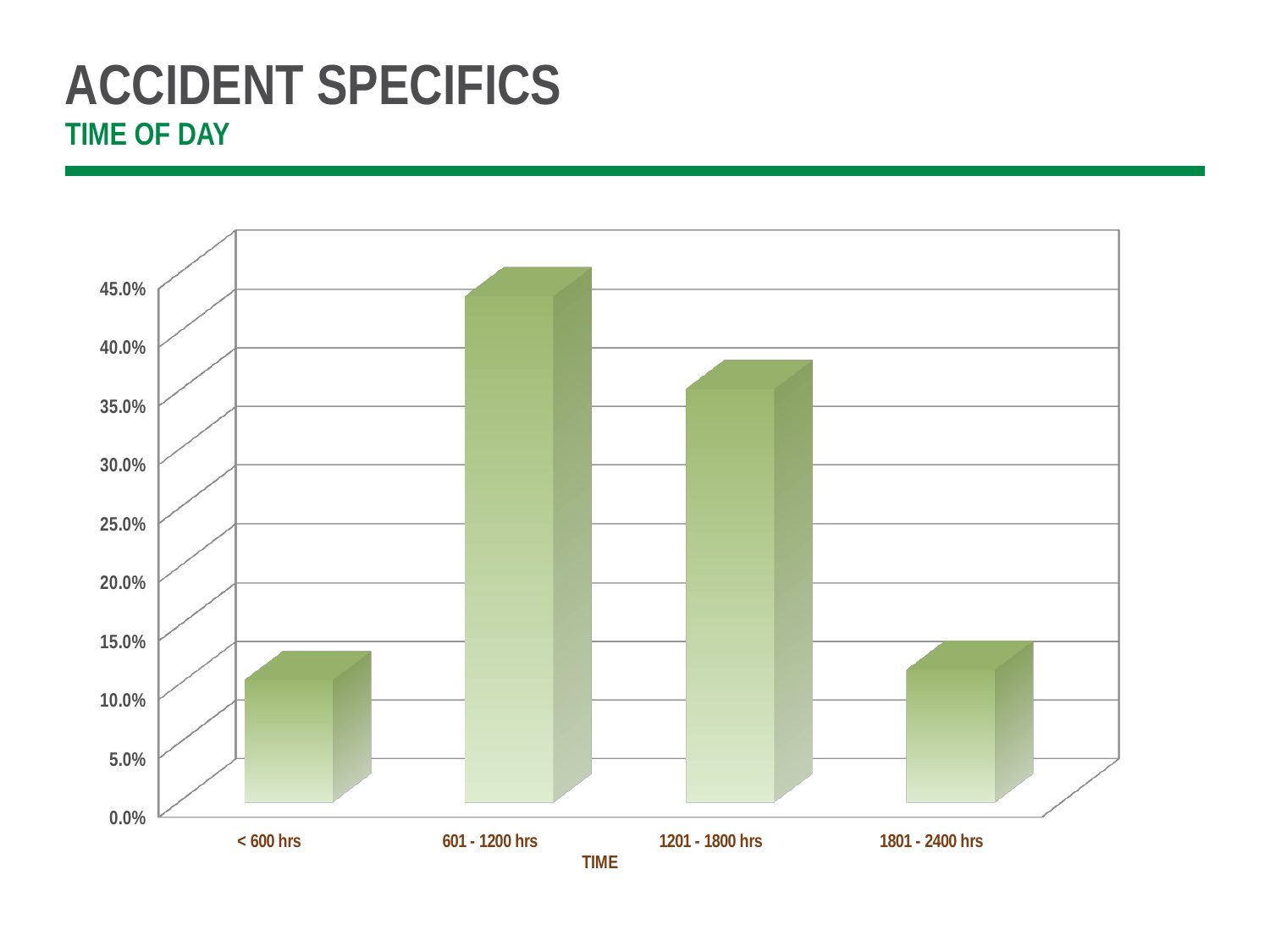
Do the values rise or fall from 601 - 1200 hrs to 1801 - 2400 hrs along the x axis? fall How many time-of-day categories are shown on the x axis? 4 Which is larger, the value for 601 - 1200 hrs or the value for 1201 - 1800 hrs? 601 - 1200 hrs What is the label of the x axis? TIME Which time-of-day category has the highest value? 601 - 1200 hrs Is the value for 1801 - 2400 hrs greater or less than 15.0%? less Is the value for 601 - 1200 hrs greater or less than 40.0%? greater What kind of chart is shown on the slide? bar chart Is the value for < 600 hrs greater or less than 15.0%? less What is the subtitle of the slide below 'ACCIDENT SPECIFICS'? TIME OF DAY Which is larger, the value for 1201 - 1800 hrs or the value for < 600 hrs? 1201 - 1800 hrs